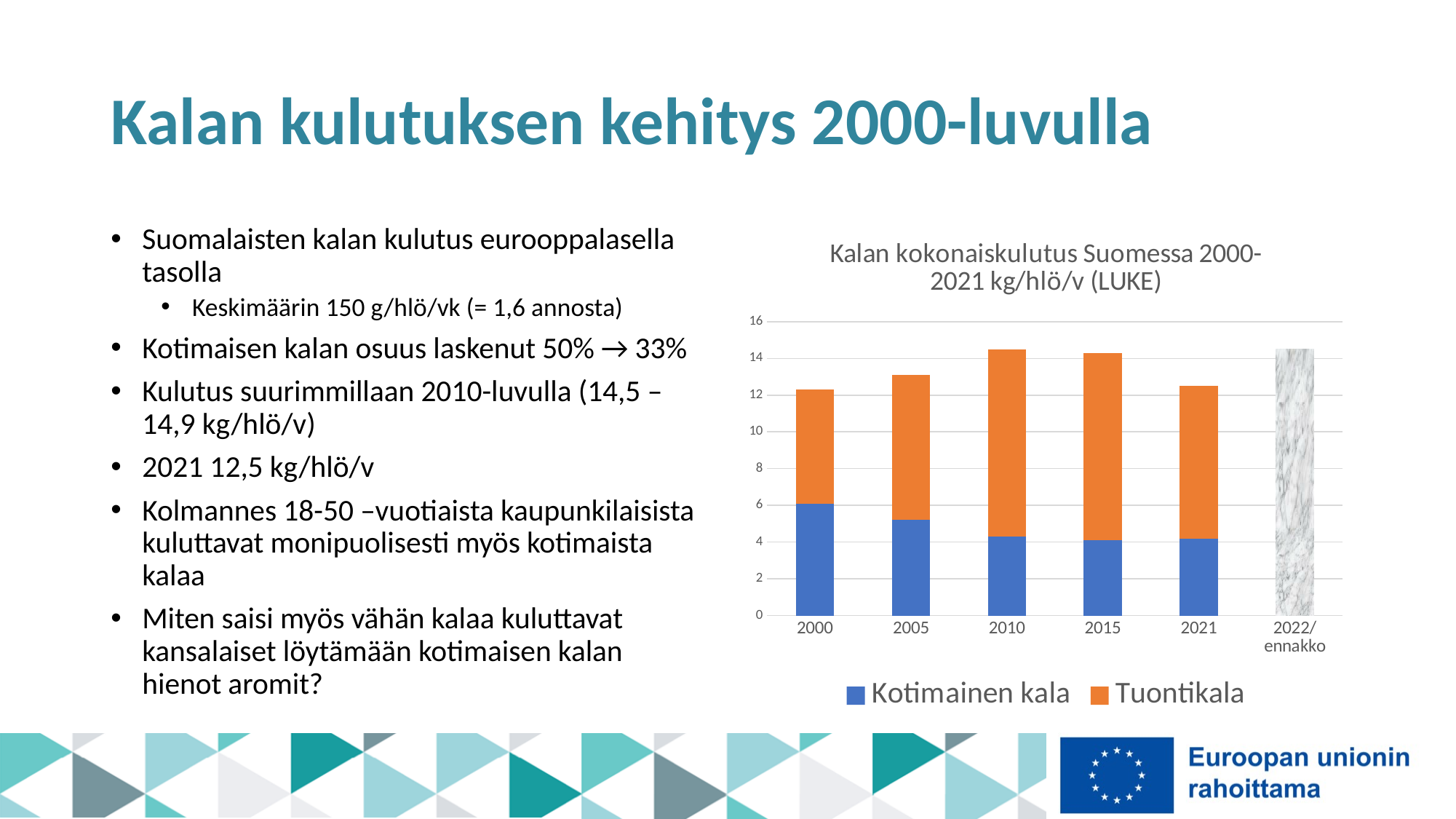
Which series is shown in orange in the chart? Tuontikala Is the total stacked value for 2010 greater or less than 14? greater Is the Kotimainen kala value for 2005 greater or less than 4? greater How many categories are labelled on the x axis of the chart? 6 Which is larger, the Tuontikala value for 2000 or for 2010? 2010 What kind of chart is shown on the slide? Stacked bar chart Is the total stacked value for 2021 greater or less than 14? less In which year is the Kotimainen kala value highest? 2000 Does the Kotimainen kala value rise or fall from 2000 to 2010? Fall What is the title of the chart? Kalan kokonaiskulutus Suomessa 2000-2021 kg/hlö/v (LUKE) How many series does the chart legend list? 2